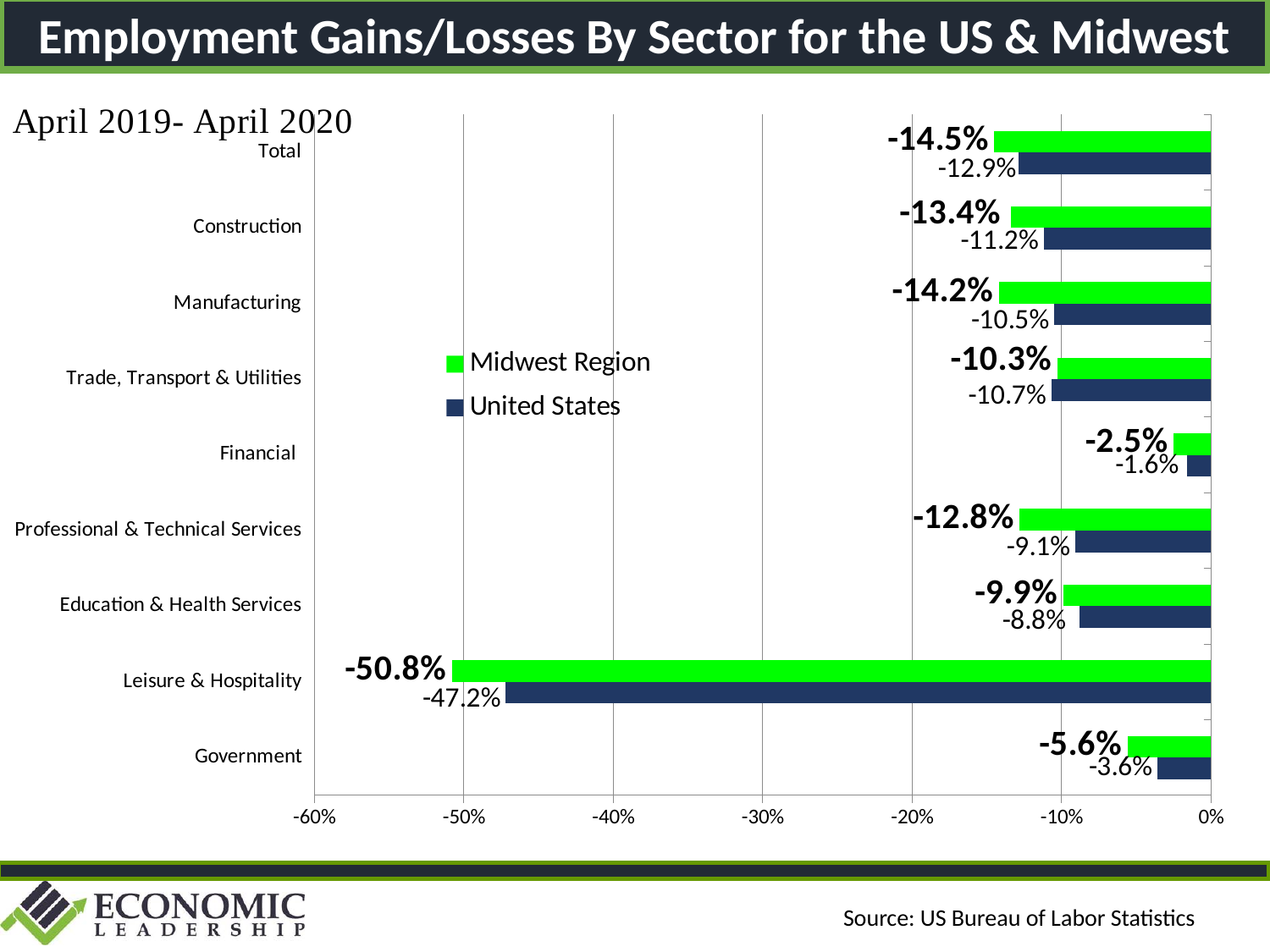
What is the Midwest Region value for Financial? -2.5% Which sector shows the largest employment loss for the Midwest Region? Leisure & Hospitality Which sector shows the smallest employment loss for the United States? Financial What is the United States value for Government? -3.6% What is the difference between the Midwest Region and United States values for Leisure & Hospitality? 3.6 percentage points What is the United States value for Manufacturing? -10.5% How many sectors (categories) are shown on the chart? 9 What type of chart is shown on the slide? Bar chart For Trade, Transport & Utilities, which has the larger loss: the Midwest Region or the United States? United States How many series does the legend list? 2 What is the Midwest Region value for Leisure & Hospitality? -50.8% What is the difference between the Midwest Region and United States values for Total? 1.6 percentage points